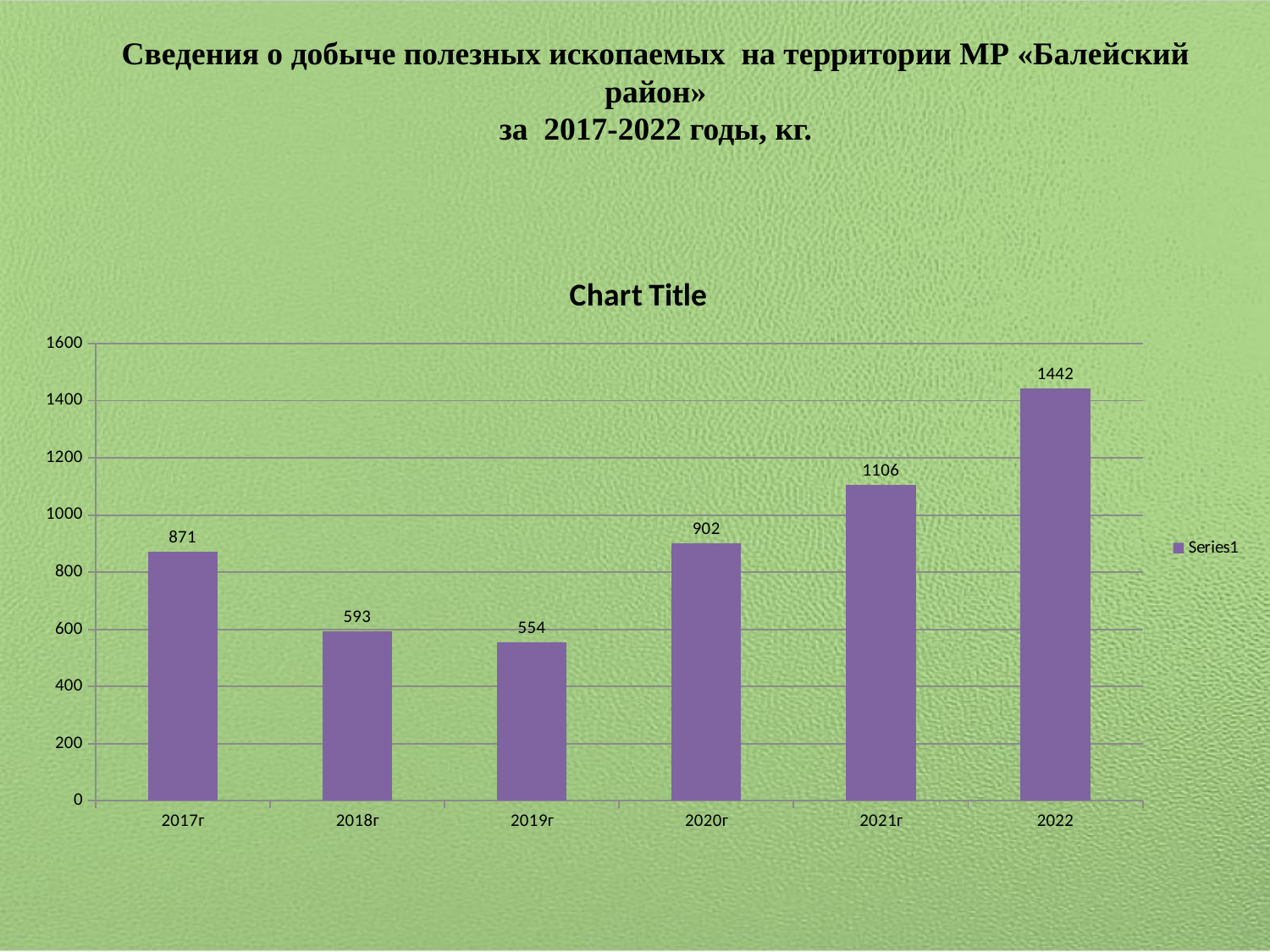
What is the name of the series listed in the legend? Series1 What is the value for 2019г? 554 Which is larger, the value for 2017г or the value for 2020г? 2020г What is the difference between the values for 2018г and 2019г? 39 What is the value for 2022? 1442 What is the value for 2017г? 871 Which year has the lowest value? 2019г How many years are shown on the x axis? 6 What kind of chart is shown on the slide? bar chart Which year has the highest value? 2022 Is the value for 2021г greater or less than 1000? greater What is the difference between the values for 2022 and 2021г? 336